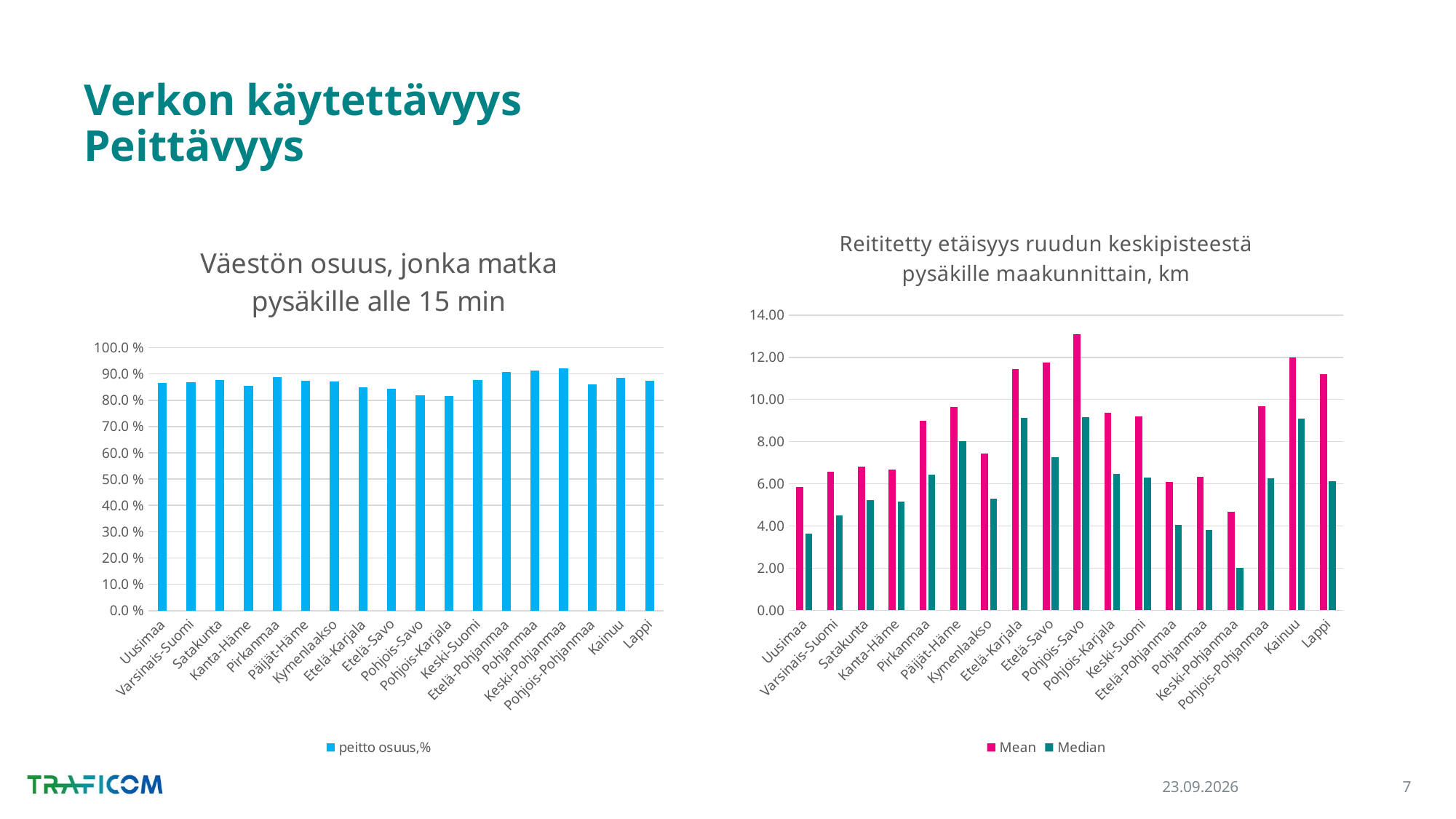
What series name does the legend of the left chart 'Väestön osuus, jonka matka pysäkille alle 15 min' show? peitto osuus,% In the right chart 'Reititetty etäisyys ruudun keskipisteestä pysäkille maakunnittain, km', is the Median value for Uusimaa greater or less than 4.00? less In the right chart 'Reititetty etäisyys ruudun keskipisteestä pysäkille maakunnittain, km', which is larger for Etelä-Savo: the Mean or the Median? Mean In the right chart 'Reititetty etäisyys ruudun keskipisteestä pysäkille maakunnittain, km', which region has the lowest Median value? Keski-Pohjanmaa In the left chart 'Väestön osuus, jonka matka pysäkille alle 15 min', which is larger: the value for Pohjois-Pohjanmaa or the value for Pohjois-Savo? Pohjois-Pohjanmaa In the right chart 'Reititetty etäisyys ruudun keskipisteestä pysäkille maakunnittain, km', is the Mean value for Kainuu greater or less than 10.00? greater How many series does the legend of the right chart 'Reititetty etäisyys ruudun keskipisteestä pysäkille maakunnittain, km' list? 2 In the left chart 'Väestön osuus, jonka matka pysäkille alle 15 min', is the value for Kanta-Häme greater or less than 90.0 %? less How many regions are shown on the x axis of the left chart 'Väestön osuus, jonka matka pysäkille alle 15 min'? 18 What kind of chart is the left chart titled 'Väestön osuus, jonka matka pysäkille alle 15 min'? bar chart In the right chart 'Reititetty etäisyys ruudun keskipisteestä pysäkille maakunnittain, km', which region has the highest Mean value? Pohjois-Savo